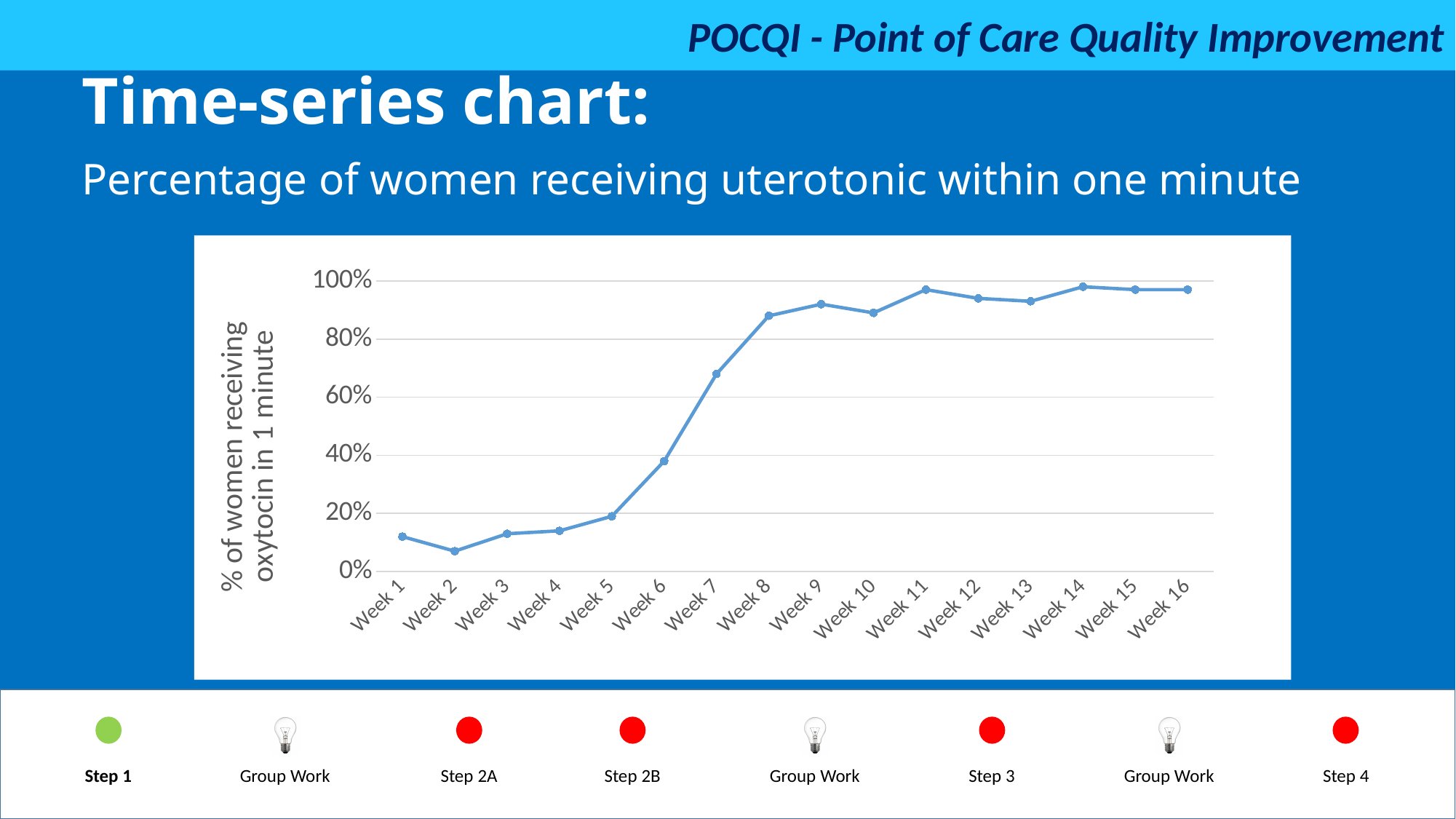
What is the label on the vertical axis of the chart? % of women receiving oxytocin in 1 minute Is the value for Week 3 greater or less than 20%? less Which is larger, the value for Week 1 or the value for Week 2? Week 1 What kind of chart is shown on the slide? line chart Which week has the lowest percentage of women receiving oxytocin in 1 minute? Week 2 Is the value for Week 8 greater or less than 80%? greater Which is larger, the value for Week 6 or the value for Week 7? Week 7 Is the value for Week 10 greater or less than 80%? greater How many weeks are plotted on the x axis? 16 Overall, do the values rise or fall from Week 1 to Week 16? rise